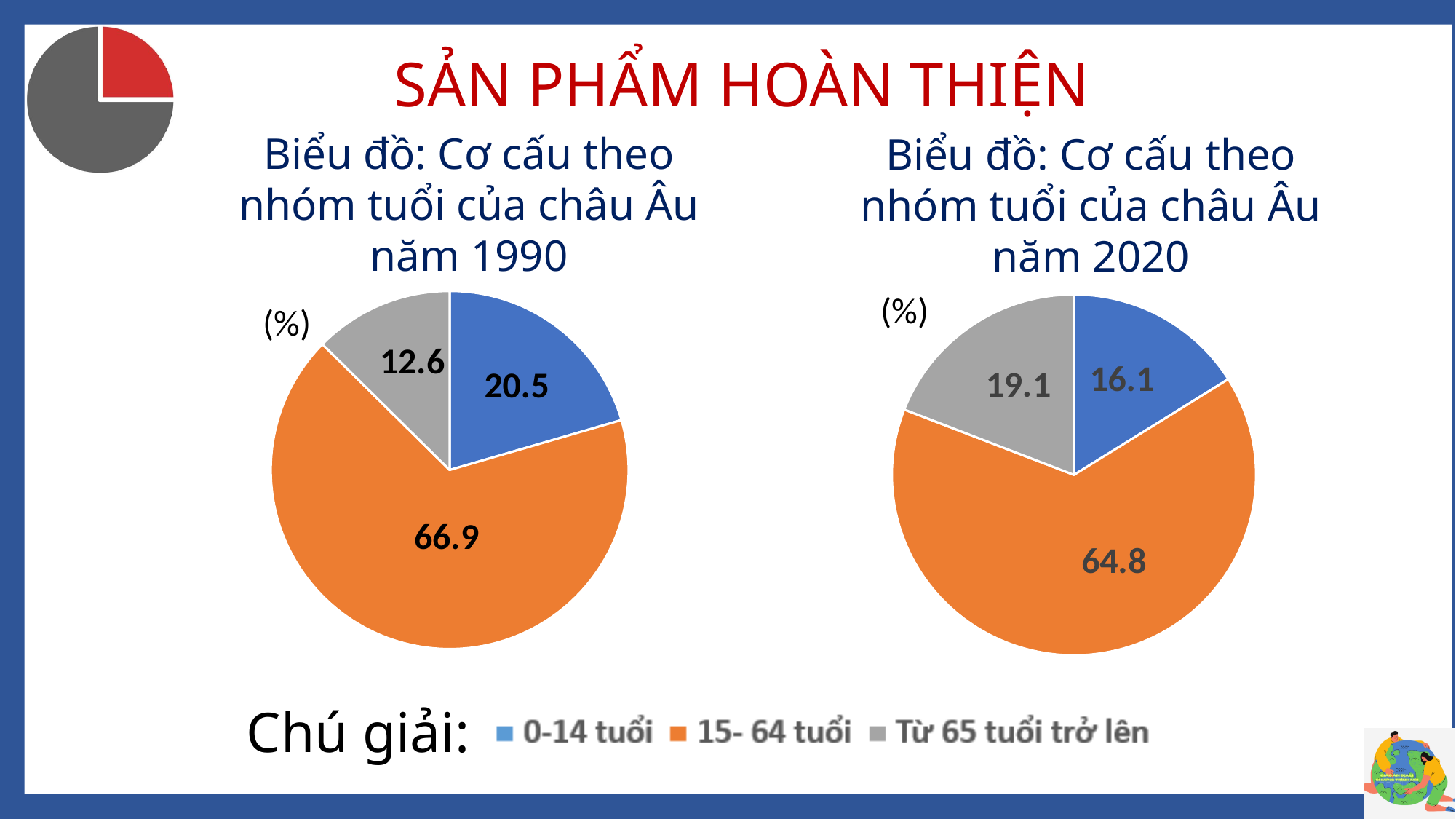
In the 2020 pie chart (right), is the value for 0-14 tuổi greater or less than 20? less Comparing the two charts, is the 0-14 tuổi value larger in 1990 or in 2020? 1990 In the 2020 pie chart (right), which age group has the largest share? 15- 64 tuổi In the legend, which age group is shown in orange? 15- 64 tuổi In the 2020 pie chart (right), what is the difference between the 15- 64 tuổi value and the 0-14 tuổi value? 48.7 In the 1990 pie chart (left), which age group has the smallest share? Từ 65 tuổi trở lên How many entries does the shared legend (Chú giải) list? 3 In the 1990 pie chart (left), what is the value for the 15- 64 tuổi group? 66.9 What type of chart is used for the 2020 chart (right)? Pie chart In the 1990 pie chart (left), what is the value for the 0-14 tuổi group? 20.5 In the 2020 pie chart (right), what is the value for the Từ 65 tuổi trở lên group? 19.1 How many slices does the 1990 pie chart (left) have? 3